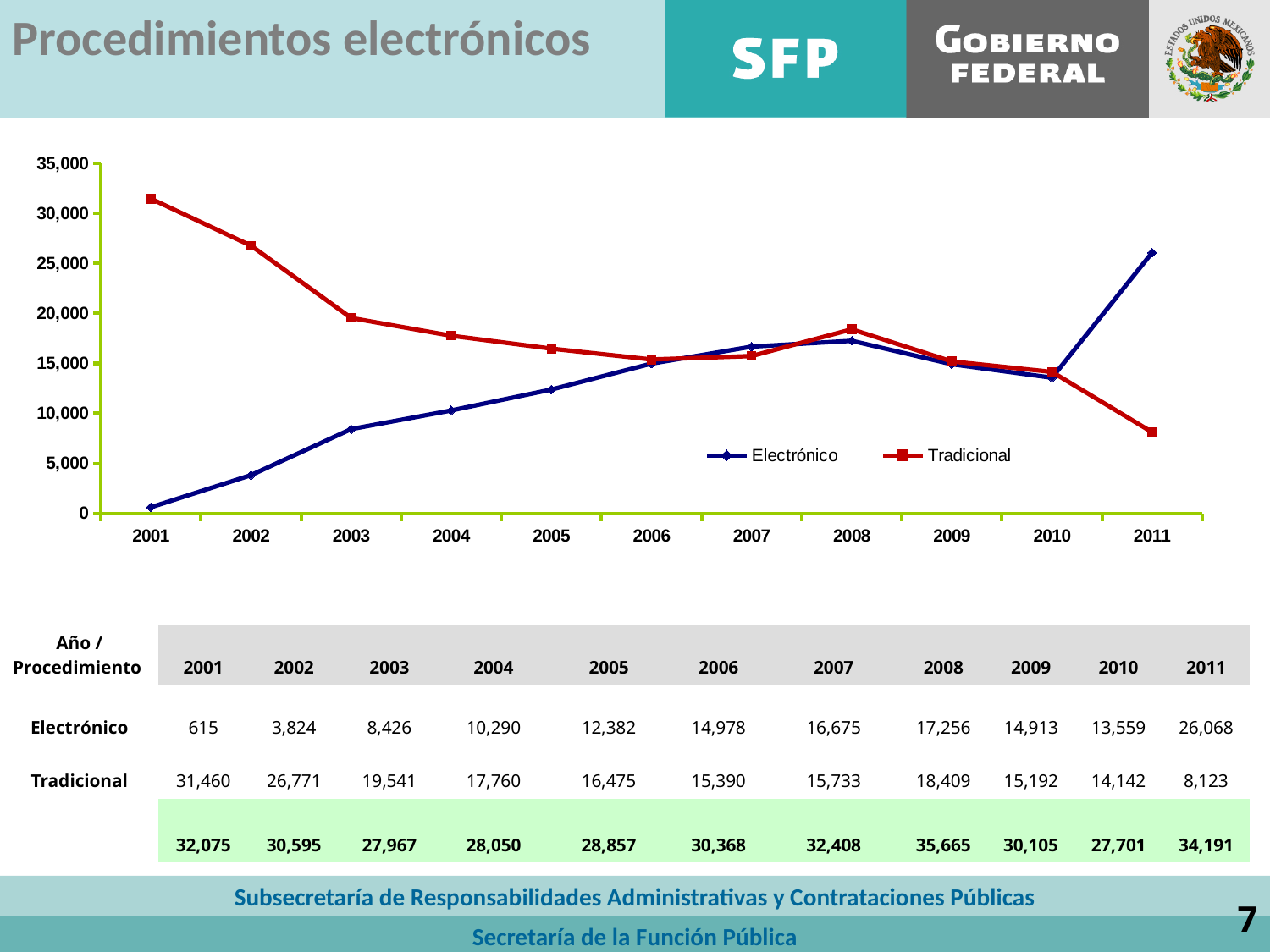
Is the value for Tradicional in 2003 greater or less than 20,000? less What kind of chart is shown on the slide? line chart In which year is the Tradicional series at its lowest? 2011 What is the difference between Tradicional and Electrónico in 2001? 30,845 How many years are plotted along the x axis of the chart? 11 What is the value for Tradicional in 2001? 31,460 What is the value for Electrónico in 2011? 26,068 Which series has the larger value in 2007, Electrónico or Tradicional? Electrónico What colour is the line for the Tradicional series? red How many series does the chart legend list? 2 Does the Tradicional series generally rise or fall from 2001 to 2011? fall In which year is the Electrónico series at its highest? 2011